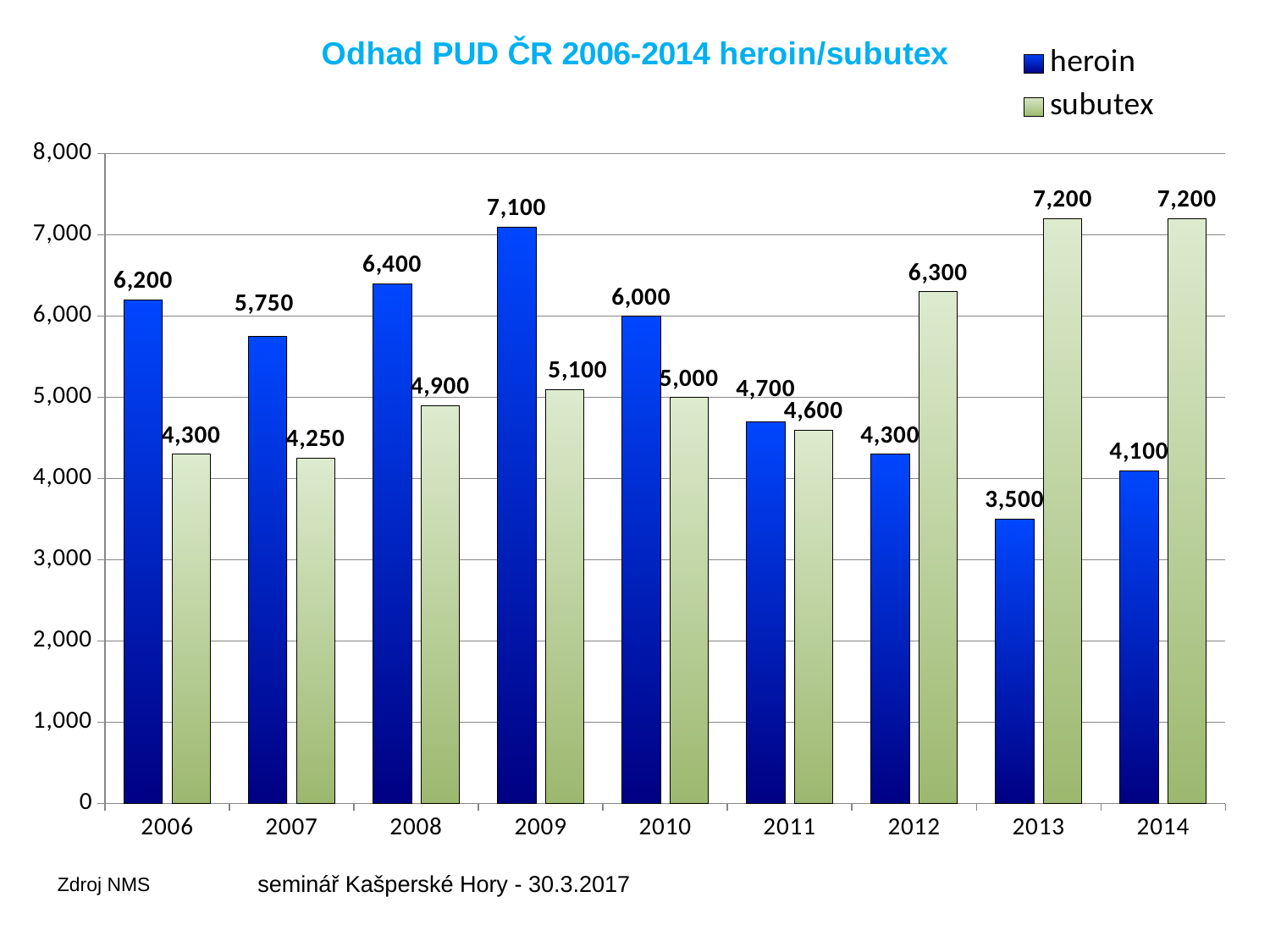
What is the heroin value for 2009? 7,100 What is the difference between the heroin and subutex values in 2006? 1,900 Does the subutex value rise or fall from 2011 to 2014? rise How many years are shown on the x axis? 9 Is the subutex value for 2014 greater or less than 7,000? greater Which year has the highest heroin value? 2009 What is the subutex value for 2012? 6,300 How many series does the legend list? 2 Which is larger in 2011, the heroin value or the subutex value? heroin Which year has the lowest subutex value? 2007 What is the heroin value for 2013? 3,500 What kind of chart is shown on the slide? bar chart